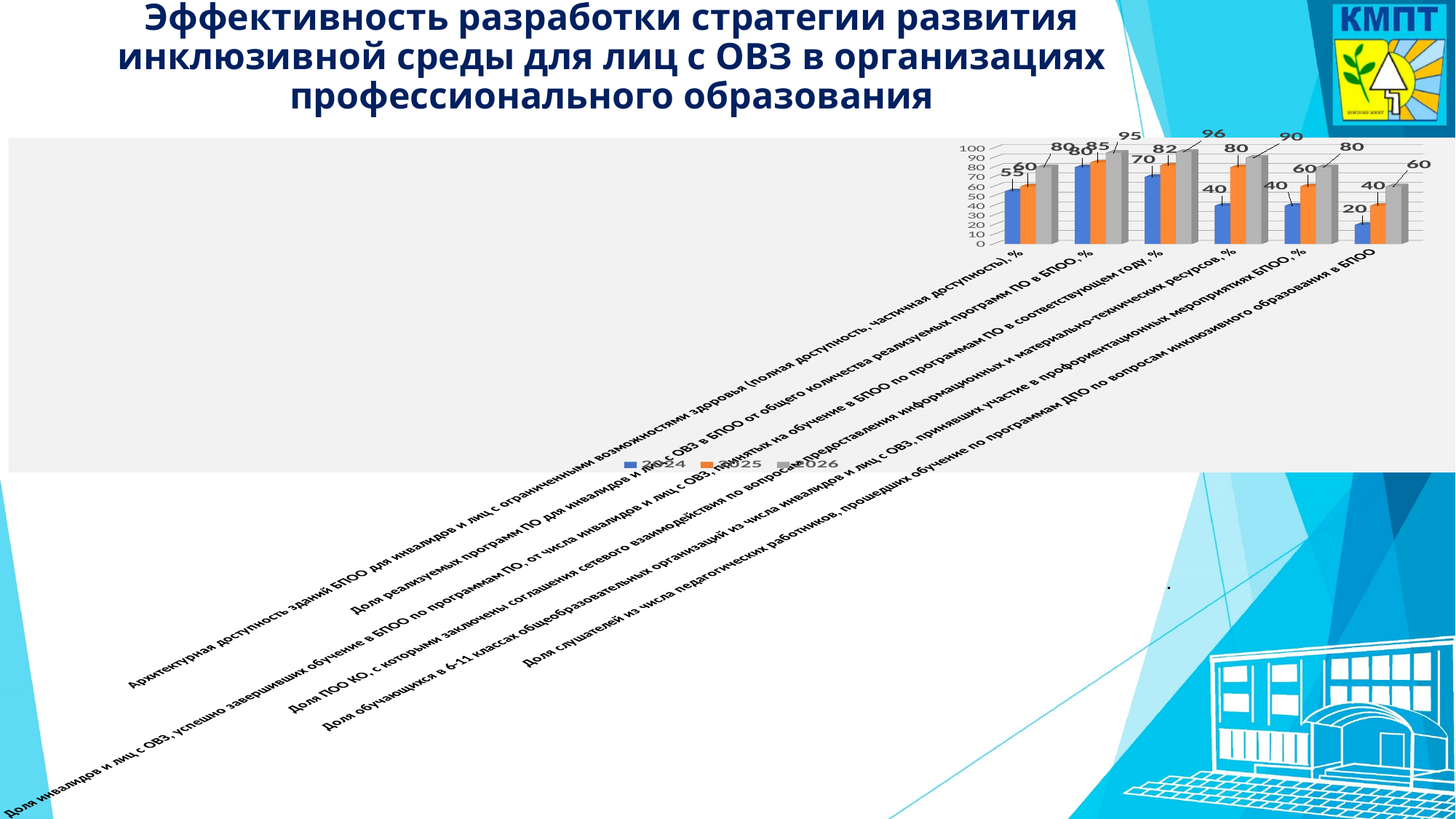
Which category has the lowest 2024 value? Доля слушателей из числа педагогических работников, прошедших обучение по программам ДПО What is the 2025 value for 'Доля ПОО КО, с которыми заключены соглашения сетевого взаимодействия'? 80 Which is larger: the 2025 value for 'Доля реализуемых программ ПО для инвалидов' or the 2025 value for 'Архитектурная доступность зданий БПОО'? Доля реализуемых программ ПО для инвалидов What is the difference between the 2026 and 2024 values for 'Доля ПОО КО, с которыми заключены соглашения сетевого взаимодействия'? 50 Which series is shown in orange in the legend? 2025 How many series does the chart legend list? 3 What is the 2026 value for 'Доля инвалидов и лиц с ОВЗ, успешно завершивших обучение в БПОО'? 96 What is the 2024 value for 'Архитектурная доступность зданий БПОО'? 55 What type of chart is shown on the slide? bar chart Do the values for 'Доля слушателей из числа педагогических работников' rise or fall from 2024 to 2026? rise Which category has the highest 2026 value? Доля инвалидов и лиц с ОВЗ, успешно завершивших обучение в БПОО How many categories are shown on the chart's x axis? 6